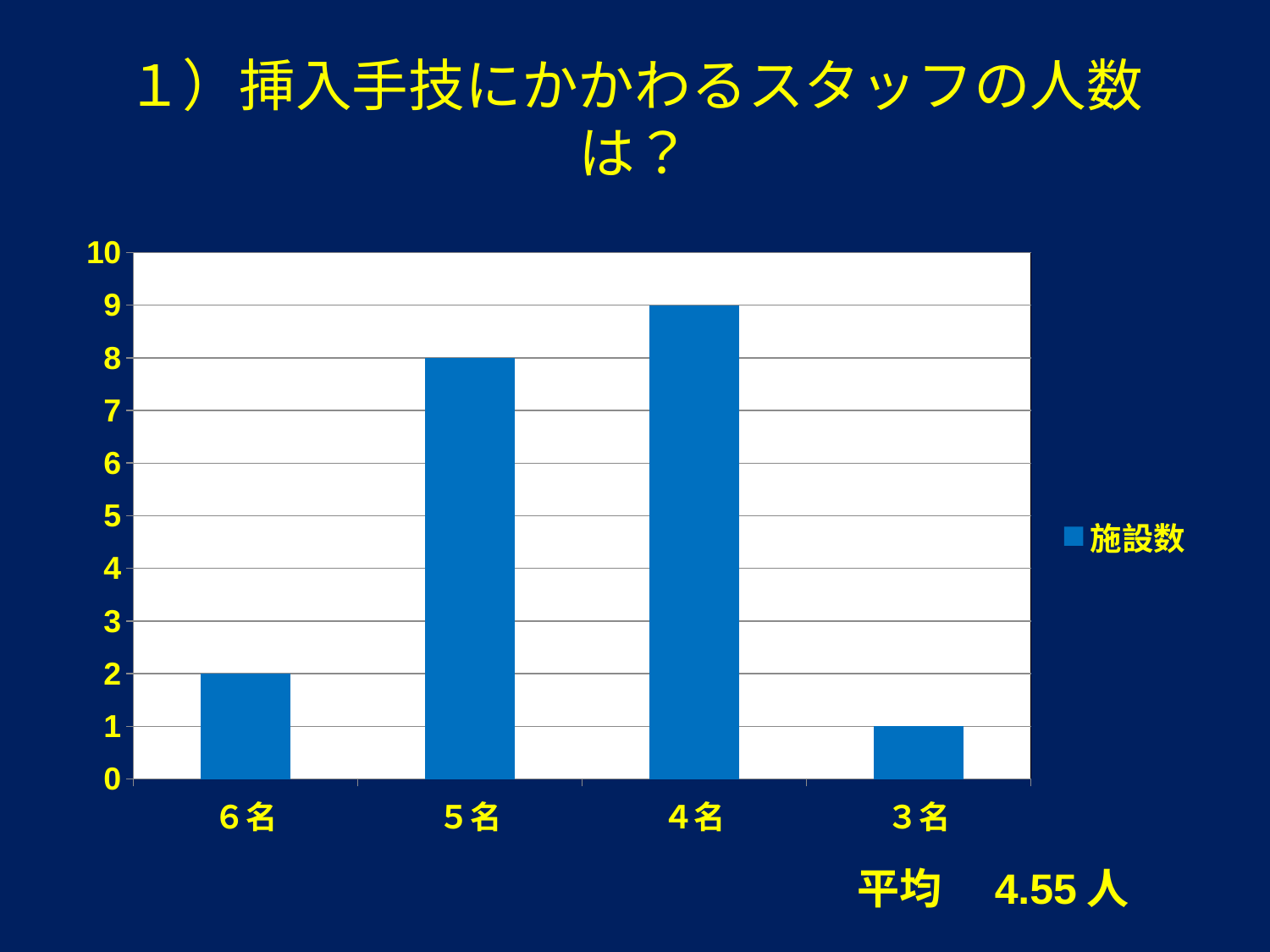
Which is larger, the value for 6名 or the value for 3名? 6名 Which category has the highest value? 4名 How many categories are shown on the x axis? 4 What is the value for 6名? 2 Which category has the lowest value? 3名 What series name does the legend show? 施設数 What is the difference between the values for 4名 and 5名? 1 What is the value for 4名? 9 What kind of chart is shown on the slide? bar chart Is the value for 5名 greater or less than 5? greater What is the value for 5名? 8 What is the value for 3名? 1